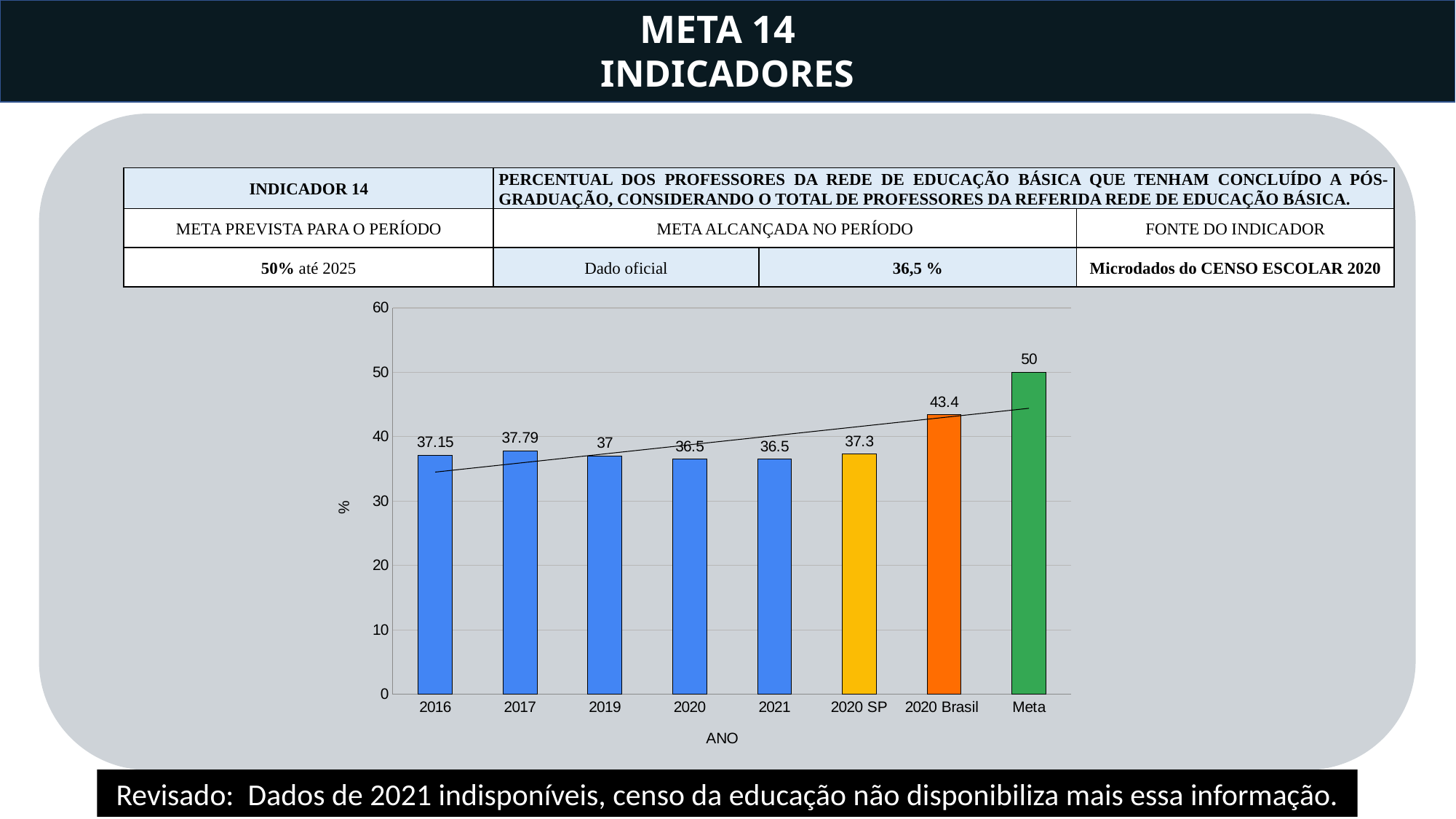
Which is larger, the value for 2020 Brasil or the value for 2020 SP? 2020 Brasil What is the value for 2017? 37.79 Is the value for 2021 greater or less than 40? less Which category has the highest value? Meta What is the value for 2020 SP? 37.3 What is the value for 2016? 37.15 What is the difference between the 2017 value and the 2016 value? 0.64 What is the difference between the Meta value and the 2020 Brasil value? 6.6 What is the value for 2020 Brasil? 43.4 What kind of chart is shown on the slide? bar chart How many bars are shown in the chart? 8 What is the label of the x axis? ANO